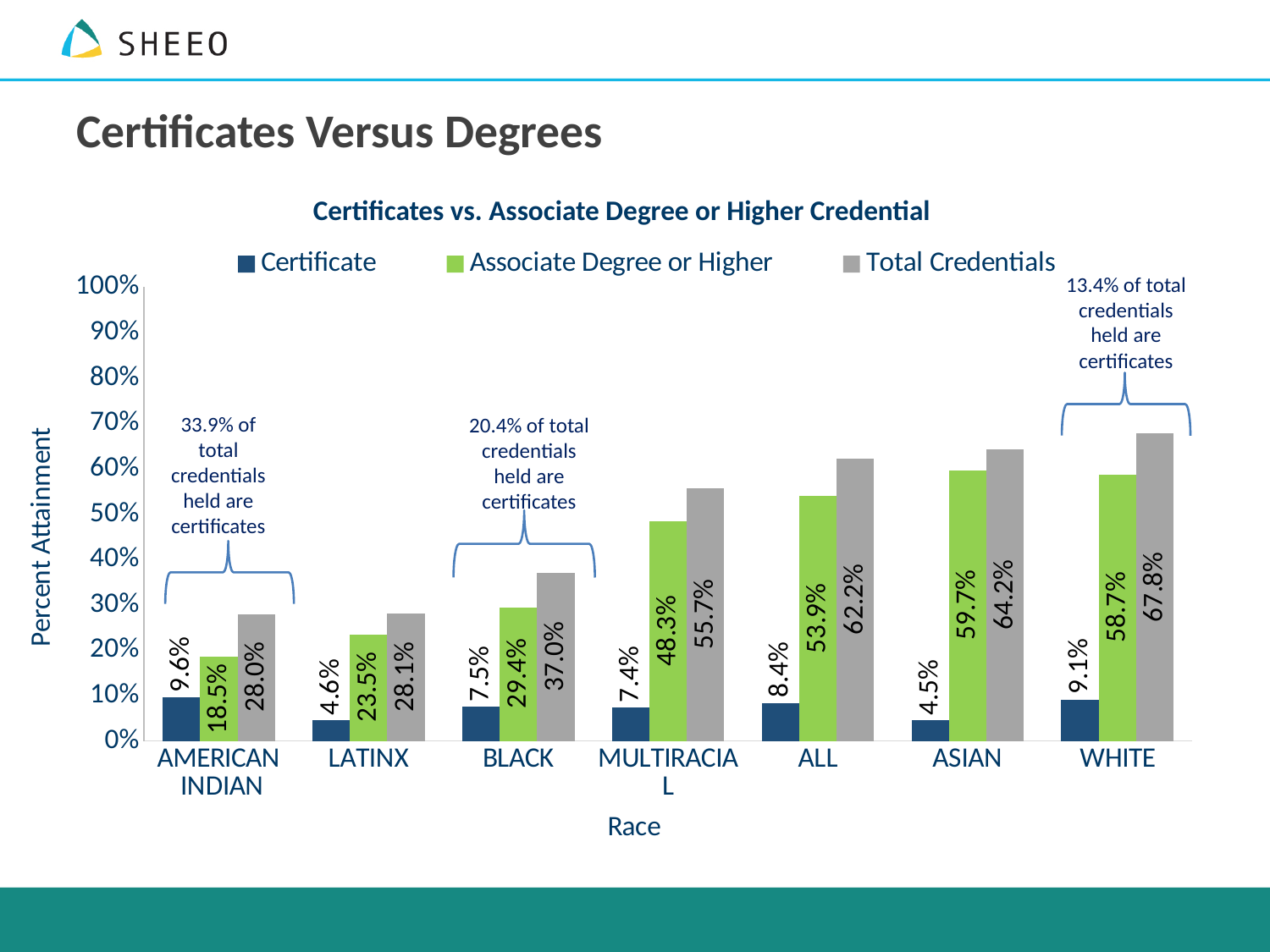
What is the Certificate value for American Indian? 9.6% Which is larger, the Associate Degree or Higher value for Asian or for White? Asian What kind of chart is shown on the slide? Bar chart What is the title of the chart? Certificates vs. Associate Degree or Higher Credential What is the difference between the Total Credentials values for White and Latinx? 39.7% What is the Total Credentials value for White? 67.8% Do the Total Credentials values rise or fall from American Indian to White along the x axis? Rise Which race has the lowest Certificate value? Asian What is the Associate Degree or Higher value for Black? 29.4% How many series does the legend list? 3 Which race has the highest Total Credentials value? White How many race categories are shown on the x axis? 7